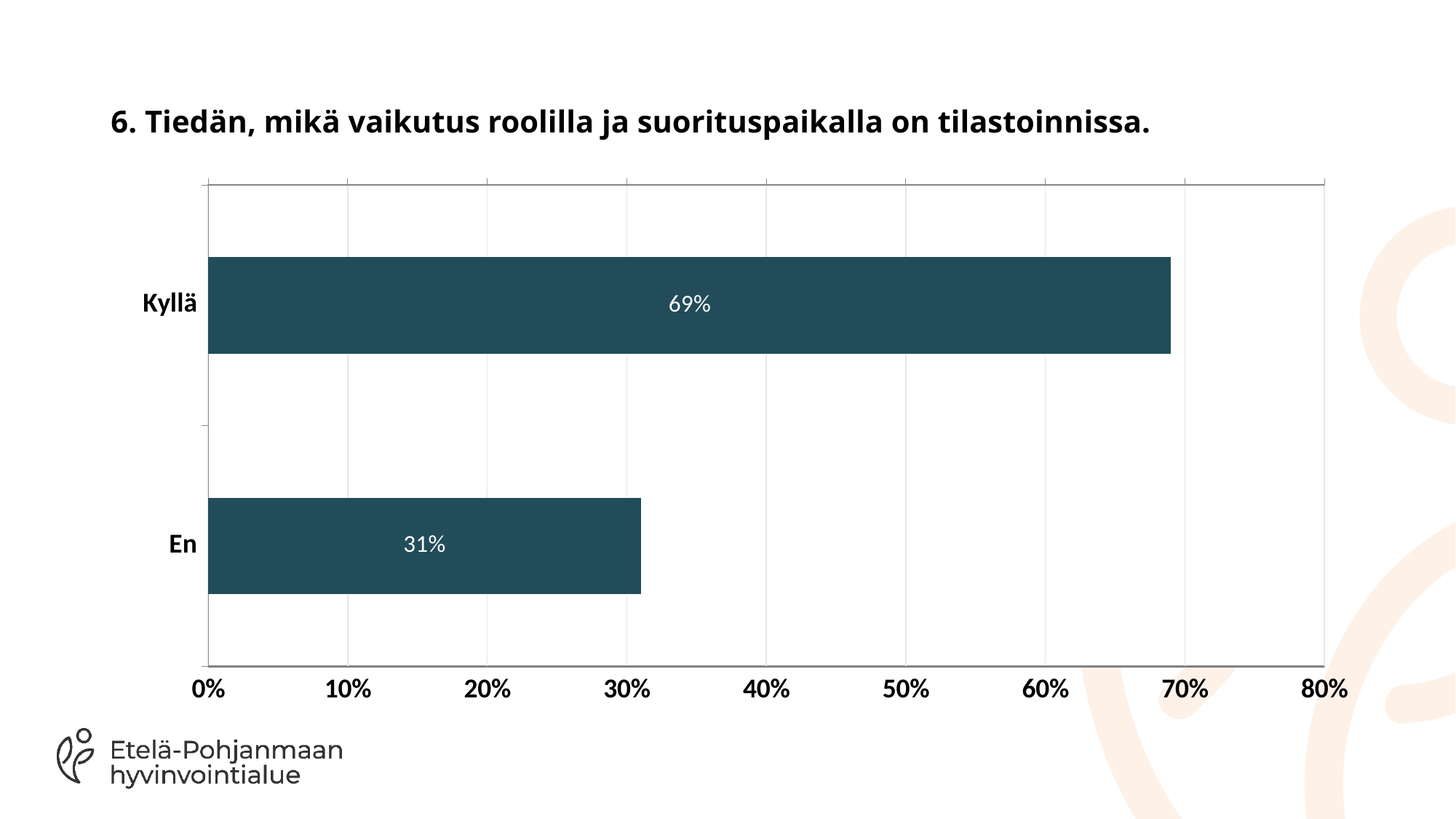
What is the value for En? 31% How many categories are shown in the chart? 2 Is the value for Kyllä greater or less than 60%? greater What is the value for Kyllä? 69% What is the difference between the values for Kyllä and En? 38% What kind of chart is shown on the slide? bar chart Which is larger, the value for Kyllä or the value for En? Kyllä Which category has the highest value? Kyllä What is the title of the chart? 6. Tiedän, mikä vaikutus roolilla ja suorituspaikalla on tilastoinnissa. Which category has the lowest value? En What is the maximum value shown on the x axis? 80% Is the value for En greater or less than 40%? less